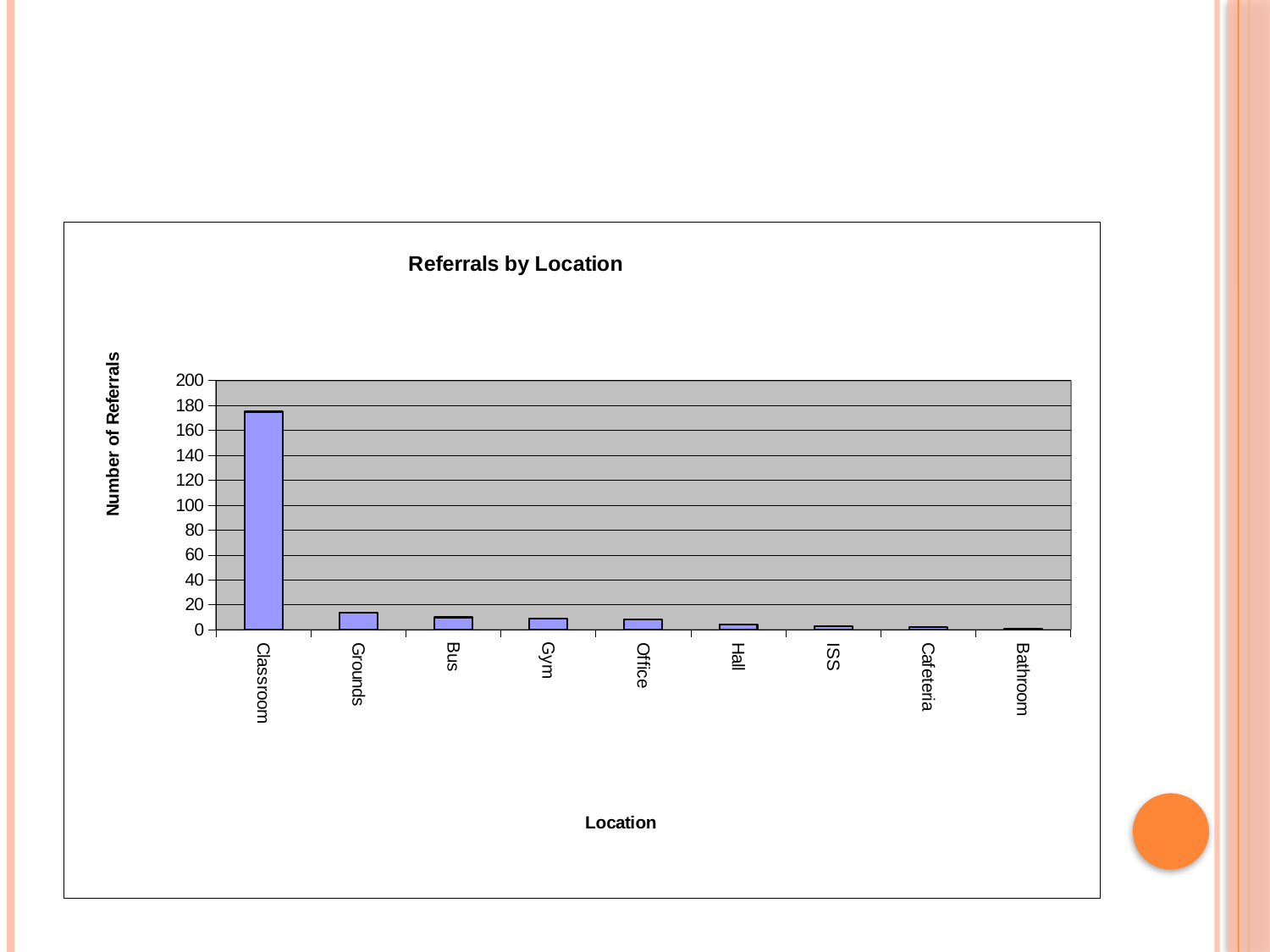
How many locations are shown on the x axis of the chart? 9 Do the values rise or fall moving from left to right along the x axis? fall Which has more referrals, Office or Hall? Office Which has more referrals, Classroom or Grounds? Classroom What kind of chart is shown on the slide? bar chart Is the value for Classroom greater or less than 160? greater What is the title of the chart? Referrals by Location Is the value for Classroom greater or less than 200? less Is the value for Hall greater or less than 20? less Which location has the highest number of referrals? Classroom What is the label on the y axis of the chart? Number of Referrals